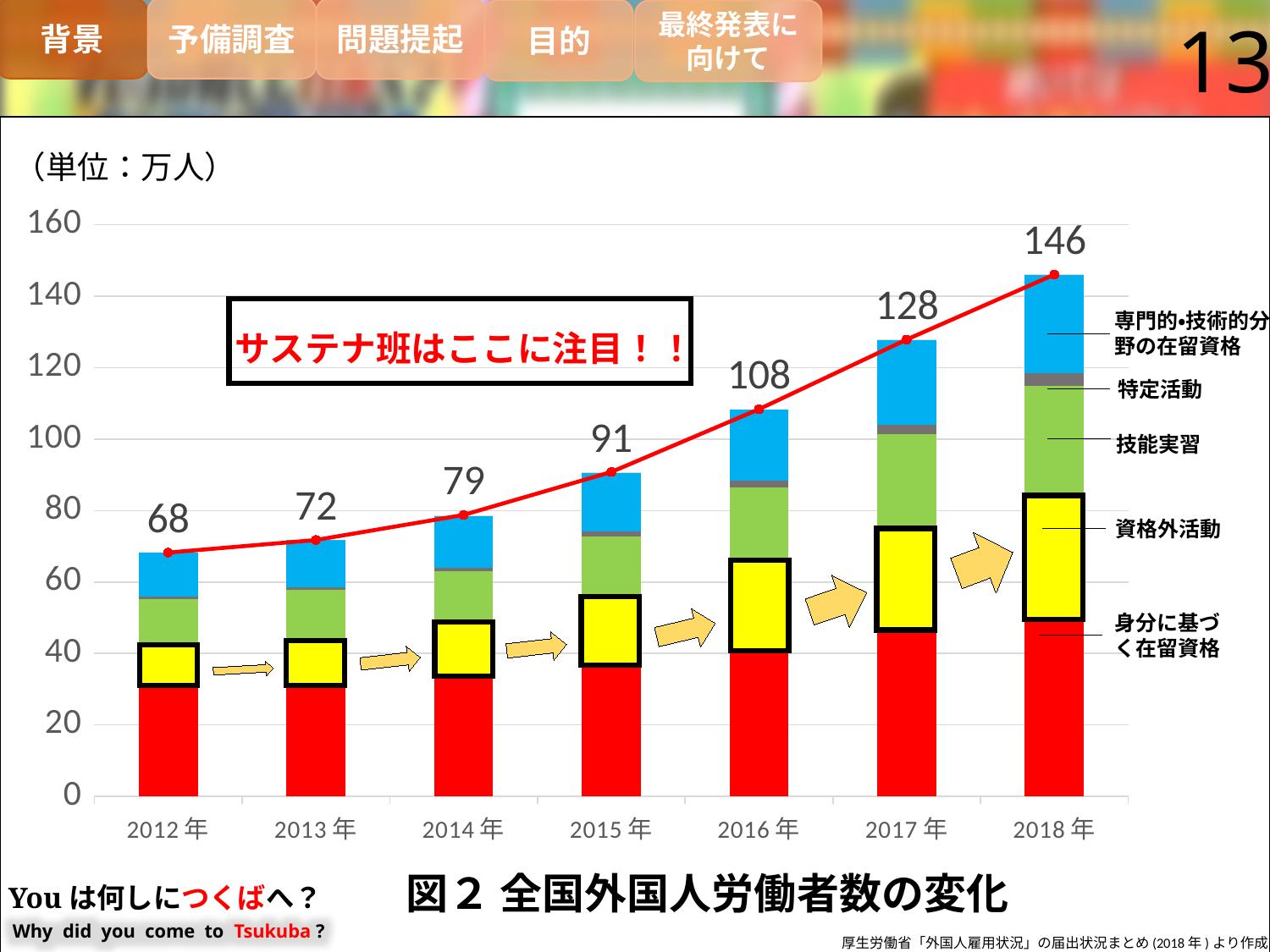
What unit is stated for the values in the chart? 万人 Which year has the highest total number of foreign workers? 2018年 Which is larger, the total for 2014年 or the total for 2013年? 2014年 What is the total value labelled for 2012年? 68 What is the total number of foreign workers shown for 2018年? 146 What is the difference between the totals for 2018年 and 2017年? 18 Which year has the lowest total number of foreign workers? 2012年 How many years are shown on the x axis? 7 What is the total value labelled for 2015年? 91 What is the difference between the totals for 2016年 and 2012年? 40 Is the value of the 身分に基づく在留資格 segment for 2012年 greater or less than 40? less Do the total values rise or fall from 2012年 to 2018年? rise